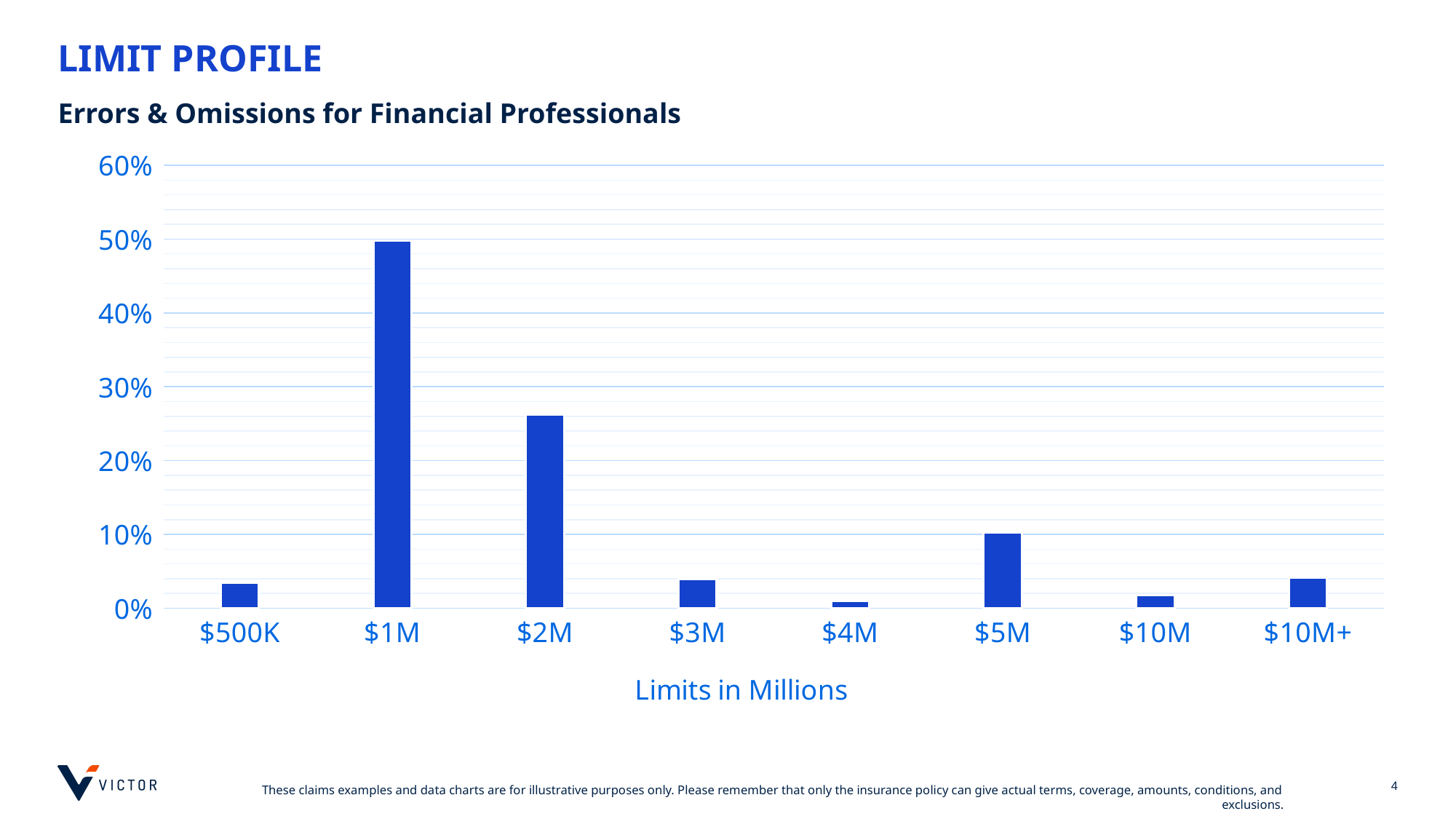
What is the title of the x axis? Limits in Millions How many limit categories are shown on the x axis? 8 Is the value for $500K greater or less than 10%? less Is the value for $10M+ greater or less than 10%? less Is the value for $1M greater or less than 40%? greater Which limit category has the highest value? $1M What kind of chart is shown on the slide? bar chart Which limit category has the lowest value? $4M Which is larger, the value for $500K or the value for $4M? $500K Which is larger, the value for $2M or the value for $5M? $2M